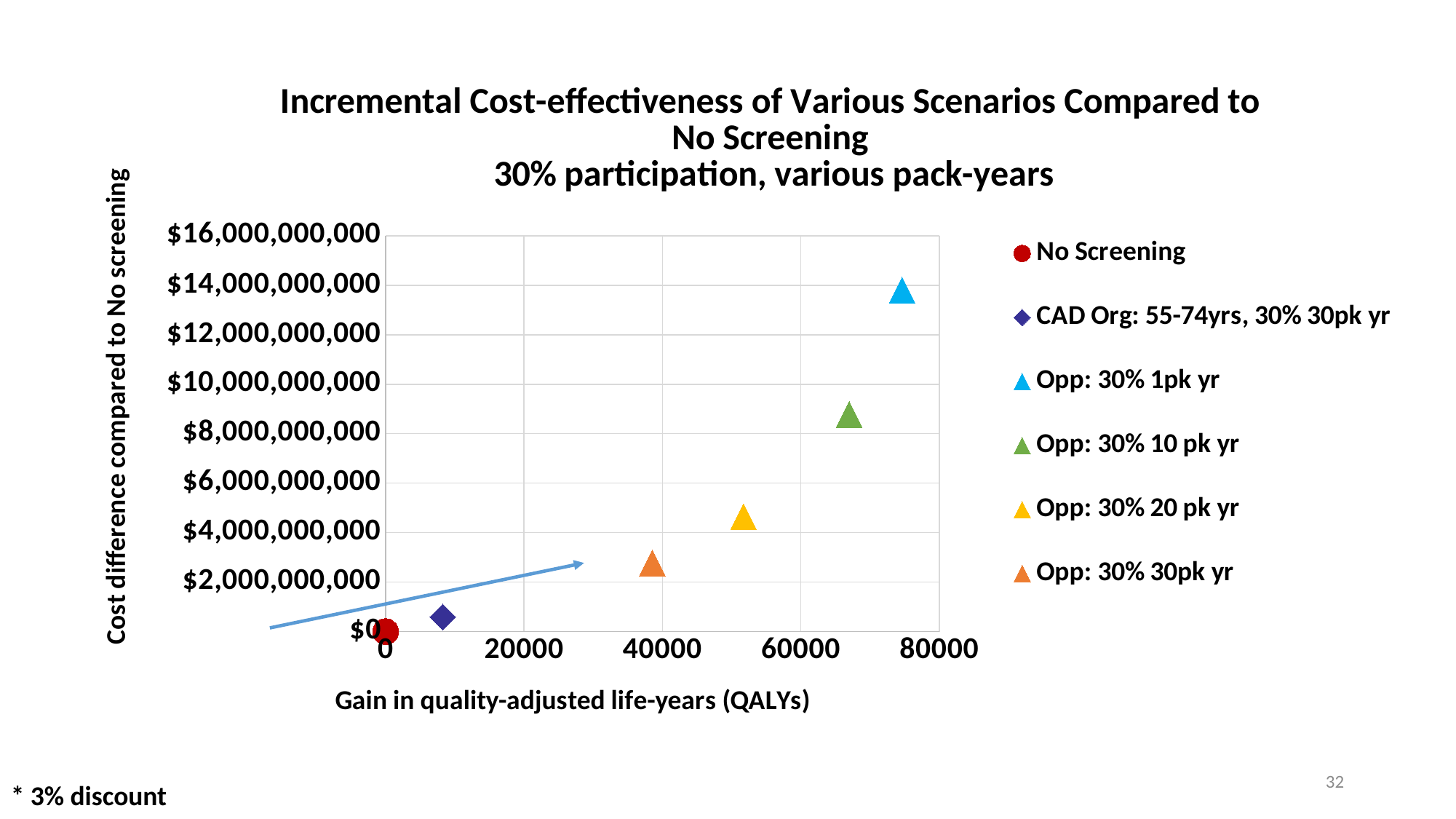
Which has the larger cost difference compared to No screening: Opp: 30% 10 pk yr or Opp: 30% 20 pk yr? Opp: 30% 10 pk yr What is the title of the x axis? Gain in quality-adjusted life-years (QALYs) Is the cost difference for Opp: 30% 20 pk yr greater or less than $6,000,000,000? less As the gain in QALYs increases along the x axis, does the cost difference rise or fall? rise Which has the larger gain in QALYs: Opp: 30% 1pk yr or CAD Org: 55-74yrs, 30% 30pk yr? Opp: 30% 1pk yr Which scenario has the highest cost difference compared to No screening? Opp: 30% 1pk yr What is the cost difference compared to No screening for the No Screening point? $0 Which scenario has the lowest gain in quality-adjusted life-years? No Screening How many series does the legend list? 6 What kind of chart is shown on the slide? scatter chart Is the gain in QALYs for Opp: 30% 30pk yr greater or less than 20000? greater Is the cost difference for Opp: 30% 1pk yr greater or less than $12,000,000,000? greater